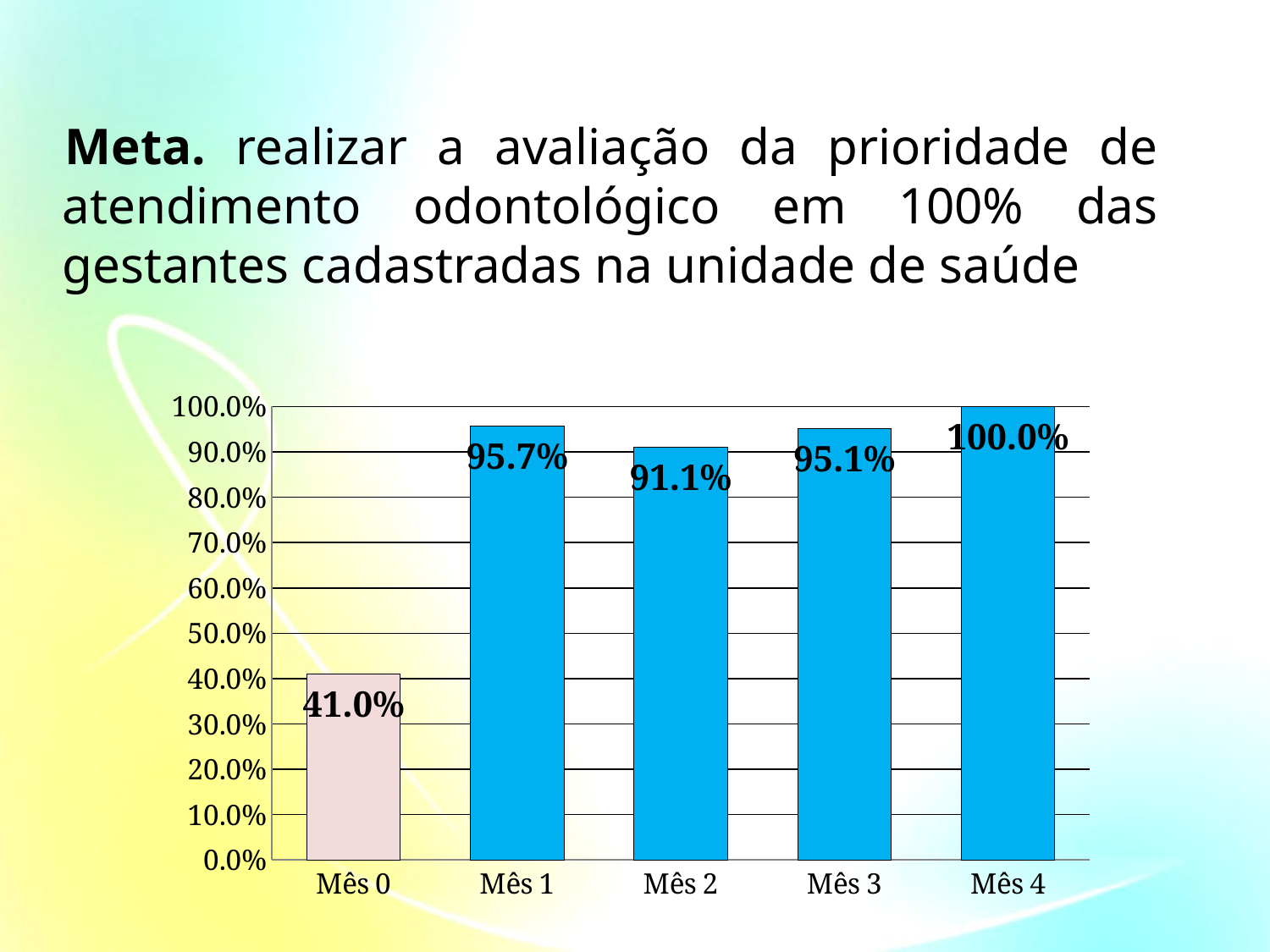
What kind of chart is shown on the slide? bar chart Which month has the lowest value? Mês 0 How many months are shown on the x axis? 5 What is the difference between the values for Mês 1 and Mês 2? 4.6% What is the value for Mês 0? 41.0% Which is larger, the value for Mês 1 or the value for Mês 2? Mês 1 What colour is the bar for Mês 0? light pink What is the difference between the values for Mês 4 and Mês 0? 59.0% What is the value for Mês 4? 100.0% Which month has the highest value? Mês 4 Is the value for Mês 0 greater or less than 50.0%? less What is the value for Mês 2? 91.1%